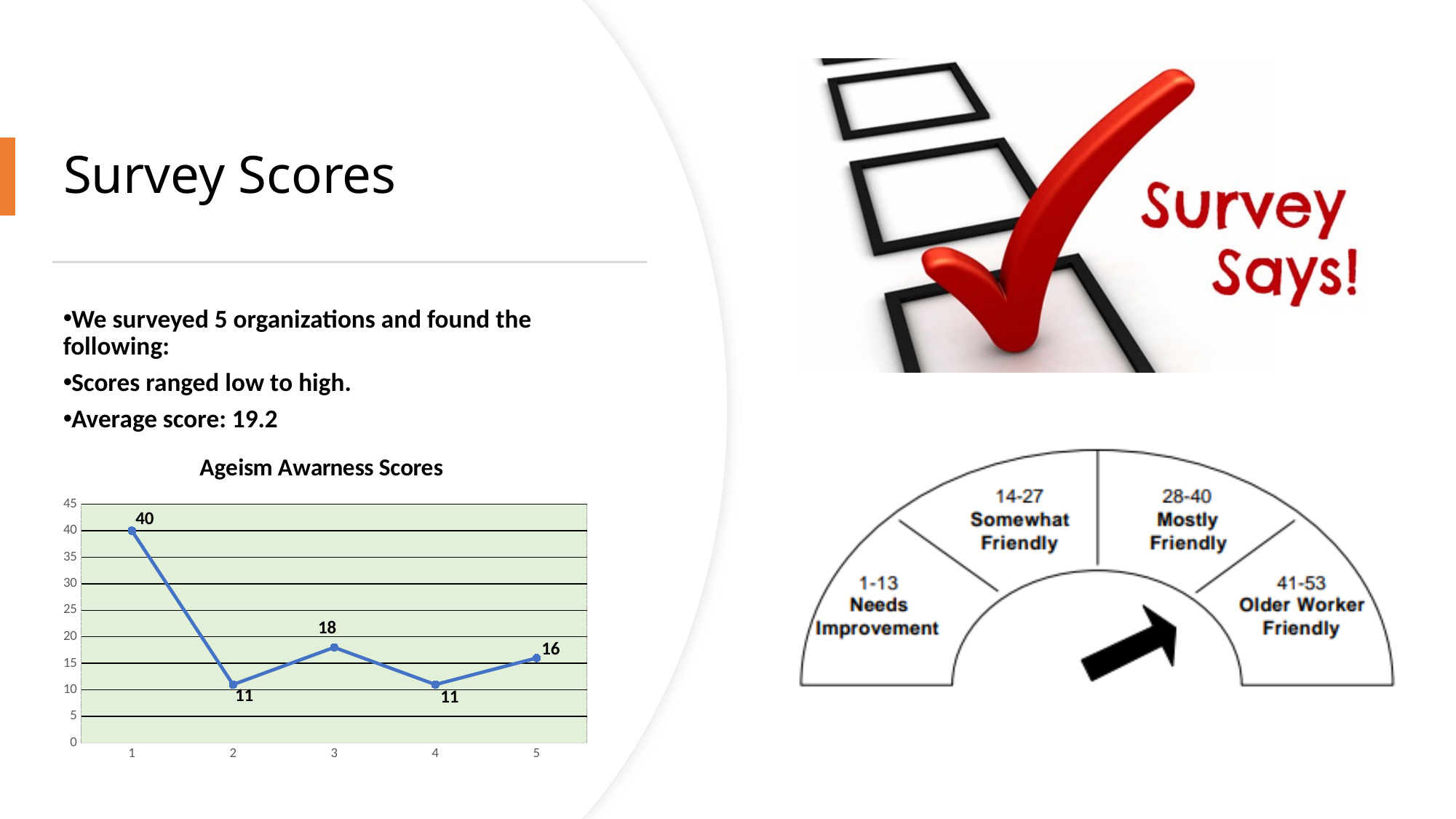
What is the value for organization 5 in the Ageism Awarness Scores chart? 16 How many organizations are plotted in the Ageism Awarness Scores chart? 5 What is the title of the chart on the slide? Ageism Awarness Scores Which organization has the highest score in the Ageism Awarness Scores chart? 1 What is the value for organization 1 in the Ageism Awarness Scores chart? 40 What is the difference between the scores for organization 1 and organization 3? 22 What is the difference between the scores for organization 5 and organization 4? 5 What kind of chart is the Ageism Awarness Scores chart? Line chart What is the lowest score shown in the Ageism Awarness Scores chart? 11 What is the value for organization 3 in the Ageism Awarness Scores chart? 18 Is the value for organization 1 greater or less than 35? greater Which is larger, the score for organization 3 or organization 5? Organization 3